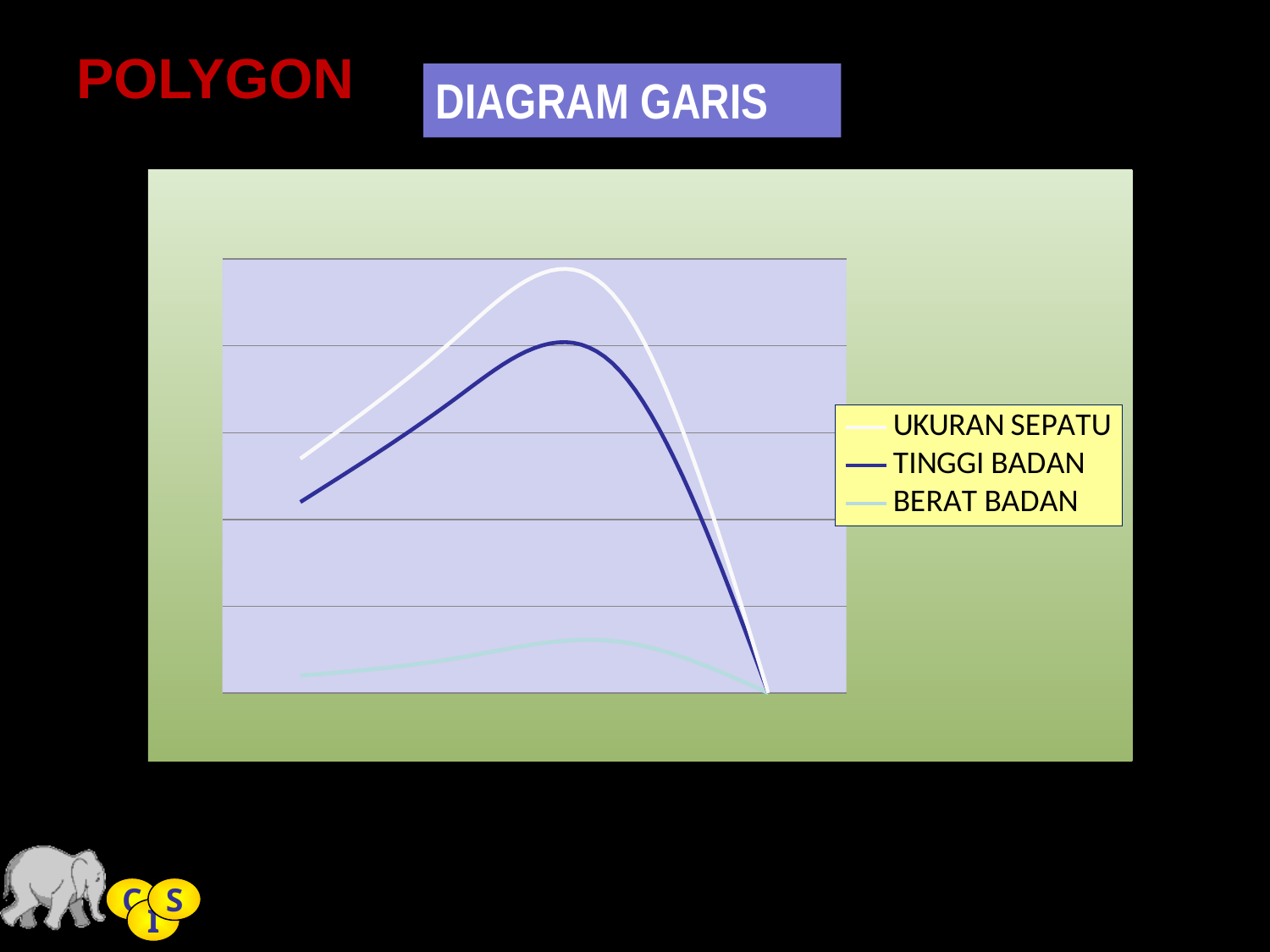
Which series is listed first in the legend? UKURAN SEPATU Does the BERAT BADAN line end higher or lower than it starts? lower Does the UKURAN SEPATU line rise or fall over the first half of the x axis? rise Does the TINGGI BADAN line rise or fall over the last part of the x axis? fall At its peak, which line is higher: UKURAN SEPATU or TINGGI BADAN? UKURAN SEPATU Which series is drawn with the dark blue line? TINGGI BADAN Which line is higher at the start of the x axis: TINGGI BADAN or BERAT BADAN? TINGGI BADAN What kind of chart is shown on the slide? line chart How many series does the legend list? 3 Which series has the highest line on the chart? UKURAN SEPATU Which series has the lowest line on the chart? BERAT BADAN